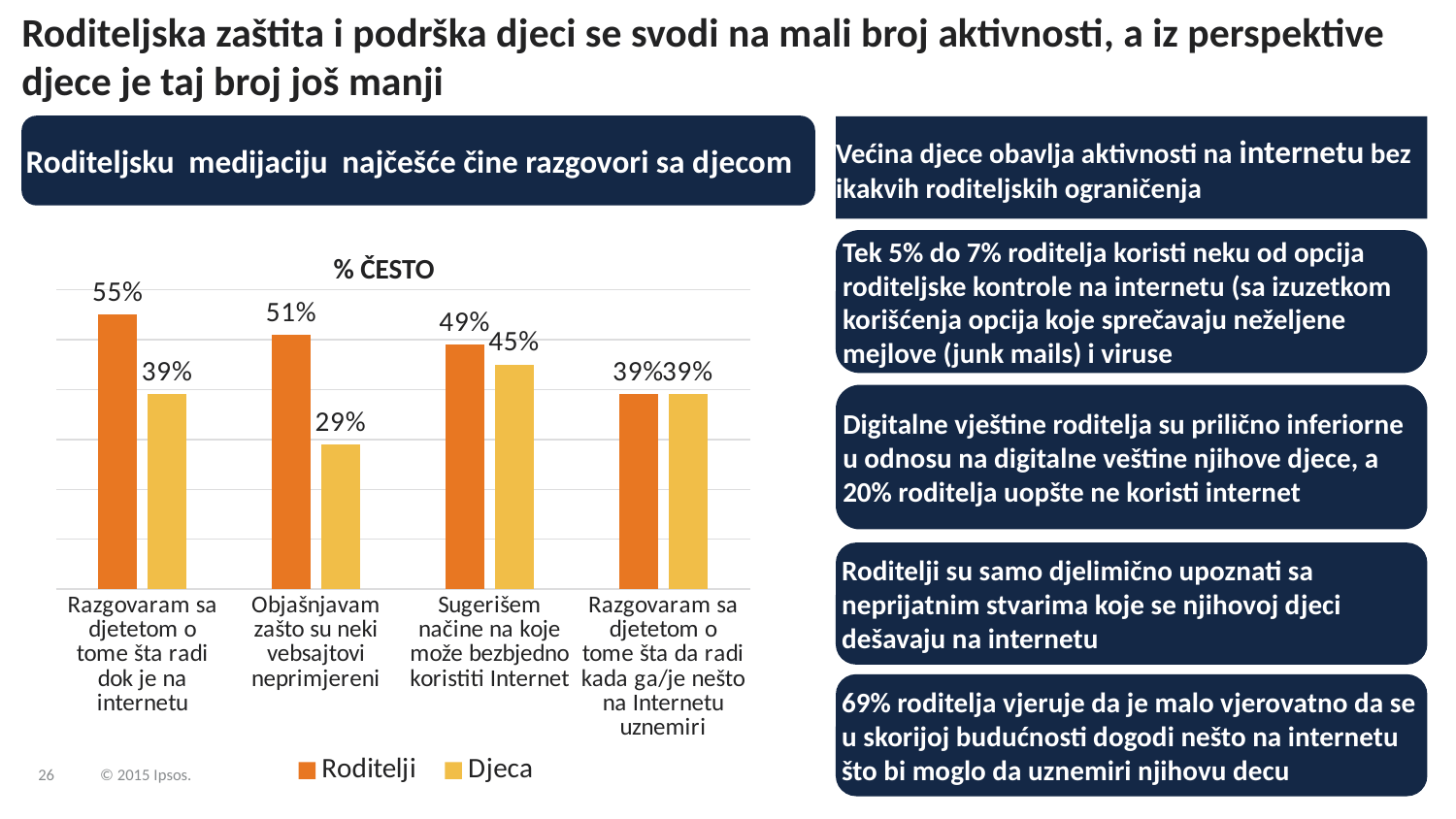
What is the value for Djeca for "Objašnjavam zašto su neki vebsajtovi neprimjereni"? 29% What is the value for Roditelji for "Razgovaram sa djetetom o tome šta radi dok je na internetu"? 55% What kind of chart is shown on the slide? Bar chart What are the Roditelji and Djeca values for "Razgovaram sa djetetom o tome šta da radi kada ga/je nešto na Internetu uznemiri"? 39% and 39% Which category has the highest value for Roditelji? Razgovaram sa djetetom o tome šta radi dok je na internetu What is the value for Djeca for "Sugerišem načine na koje može bezbjedno koristiti Internet"? 45% Which is larger for "Razgovaram sa djetetom o tome šta radi dok je na internetu": Roditelji or Djeca? Roditelji How many series does the legend list? 2 Which category has the lowest value for Djeca? Objašnjavam zašto su neki vebsajtovi neprimjereni How many categories are shown on the x axis of the chart? 4 What is the title of the chart? % ČESTO What is the difference between the Roditelji and Djeca values for "Objašnjavam zašto su neki vebsajtovi neprimjereni"? 22%